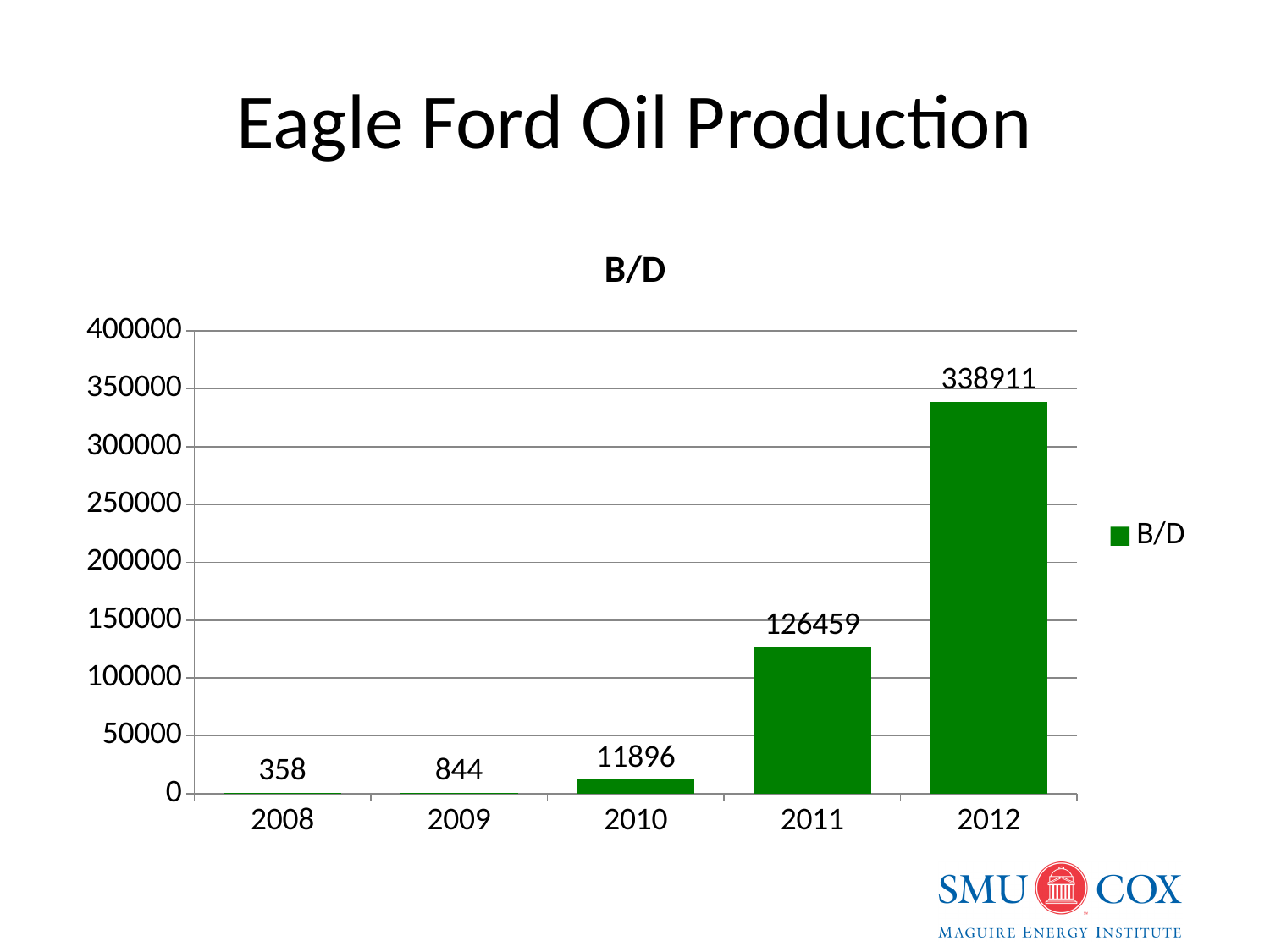
How many years are shown on the x axis? 5 Is the B/D value for 2011 greater or less than 100000? greater Do the B/D values rise or fall from 2008 to 2012? rise What is the B/D value for 2008? 358 Which year has the lowest B/D value? 2008 What kind of chart is shown on the slide? bar chart What is the difference between the B/D values for 2009 and 2008? 486 Which year has a larger B/D value, 2010 or 2011? 2011 Which year has the highest B/D value? 2012 What is the B/D value for 2010? 11896 What is the difference between the B/D values for 2012 and 2011? 212452 What is the B/D value for 2012? 338911